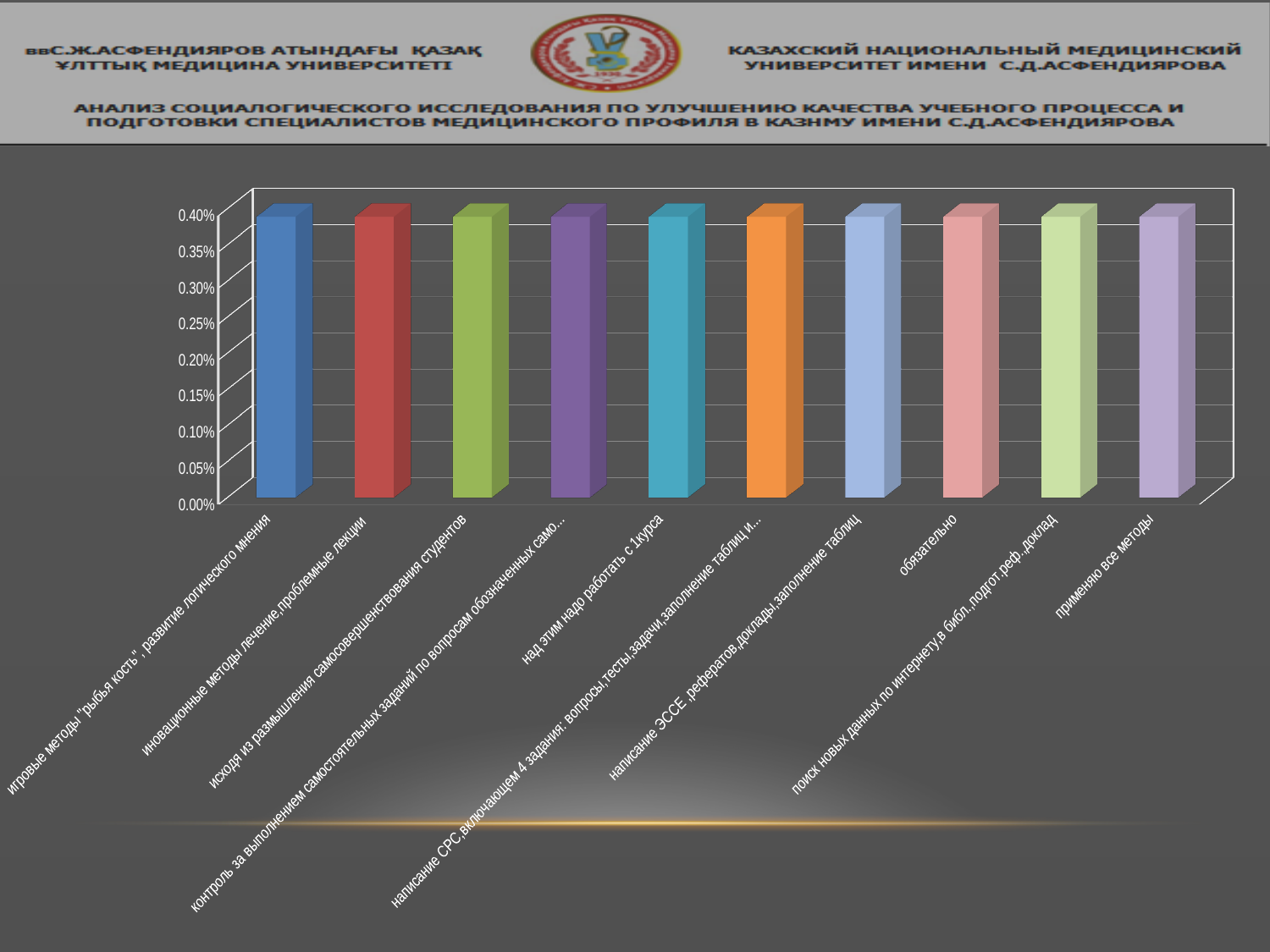
Is the value for "над этим надо работать с 1курса" greater or less than 0.10%? greater What colour is the first bar on the left ("игровые методы "рыбья кость", развитие логического мнения")? blue Is the value for "обязательно" greater or less than 0.20%? greater What is the label of the last (rightmost) category in the chart? применяю все методы What is the highest value shown on the vertical axis of the chart? 0.40% What kind of chart is shown on the slide? bar chart Is the value for "применяю все методы" greater or less than 0.30%? greater Do the bar values rise, fall, or stay flat from left to right across the chart? stay flat How many categories (bars) are plotted in the chart? 10